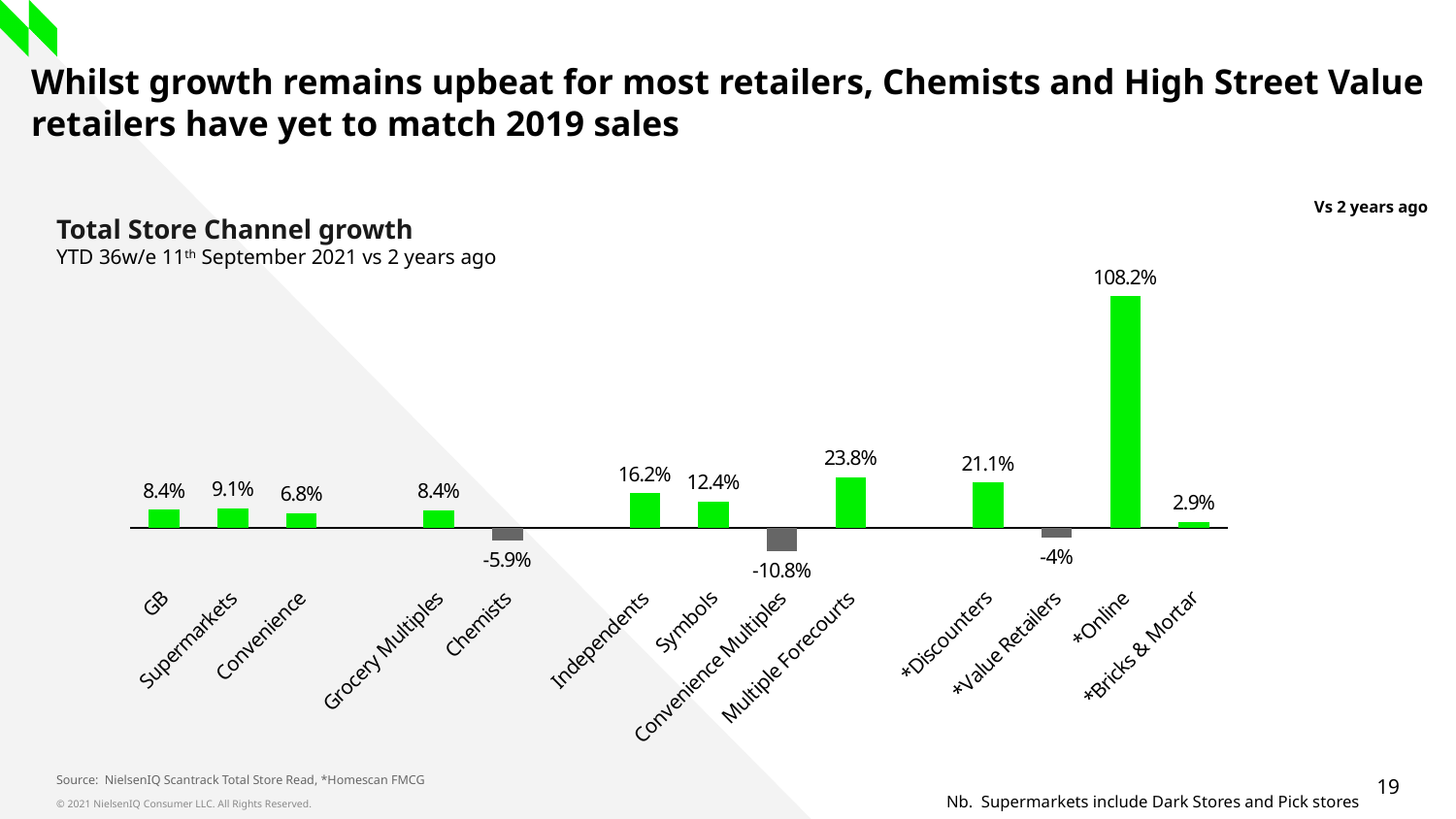
Which channel has the highest growth? *Online What kind of chart is shown on the slide? Bar chart What is the growth value for Convenience Multiples? -10.8% What is the growth value for Chemists? -5.9% How many channels are shown on the chart? 13 What is the growth value for *Online? 108.2% What colour are the bars with negative values? Grey What is the growth value for Supermarkets? 9.1% Which channel has the lowest growth? Convenience Multiples What is the difference between the growth for Multiple Forecourts and *Discounters? 2.7% Which has higher growth, Independents or Symbols? Independents What is the title of the chart? Total Store Channel growth